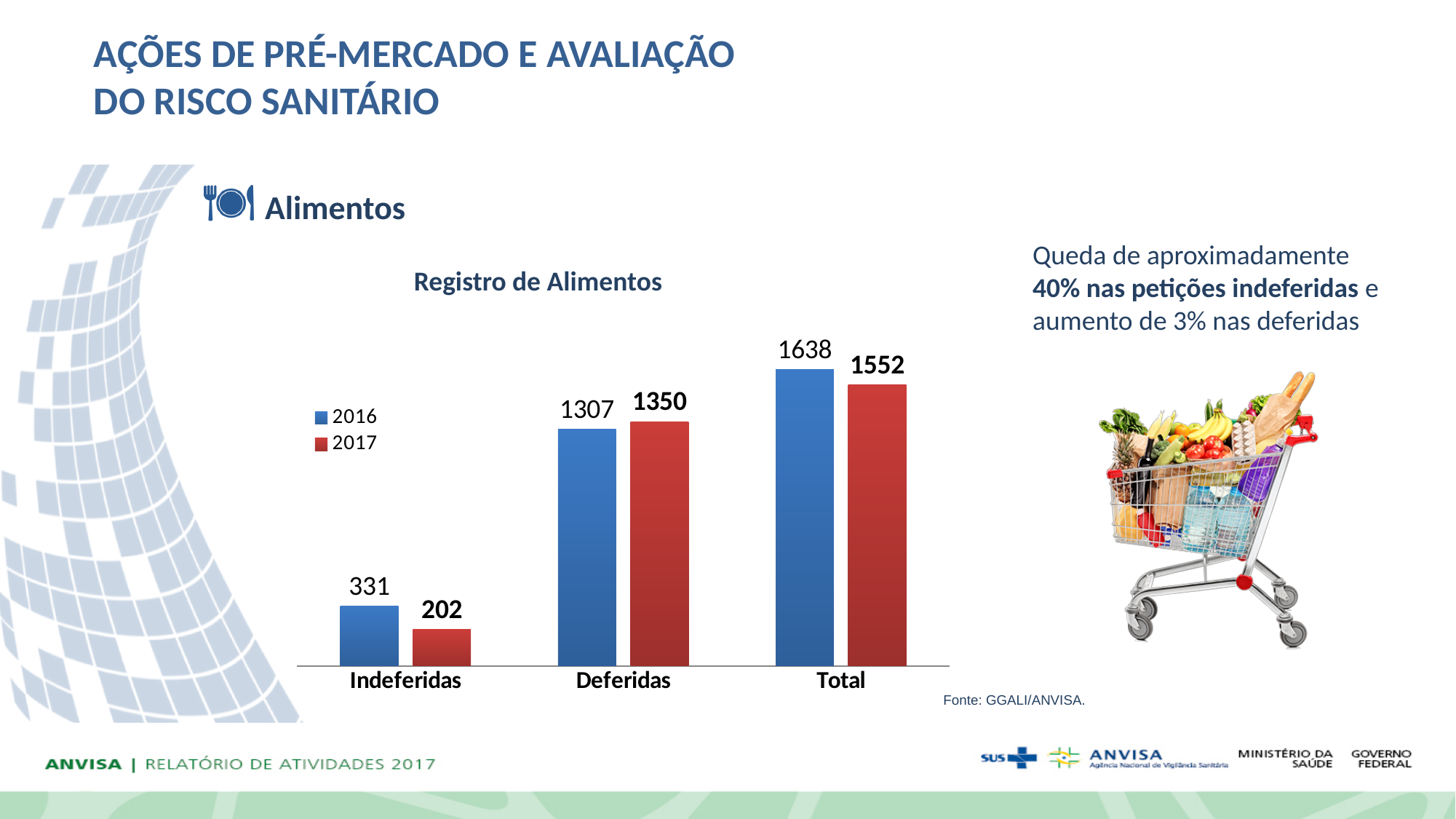
What is the value for Indeferidas in 2016? 331 Which category has the lowest value for 2017? Indeferidas What is the Total value for 2016? 1638 Which category has the highest value for 2016? Total What is the value for Deferidas in 2017? 1350 What is the difference between the 2016 and 2017 values for Indeferidas? 129 What is the difference between the 2016 and 2017 Total values? 86 What is the value for Indeferidas in 2017? 202 What is the title of the chart? Registro de Alimentos How many series does the legend list? 2 For Deferidas, which year has the larger value, 2016 or 2017? 2017 How many categories are shown on the x axis? 3